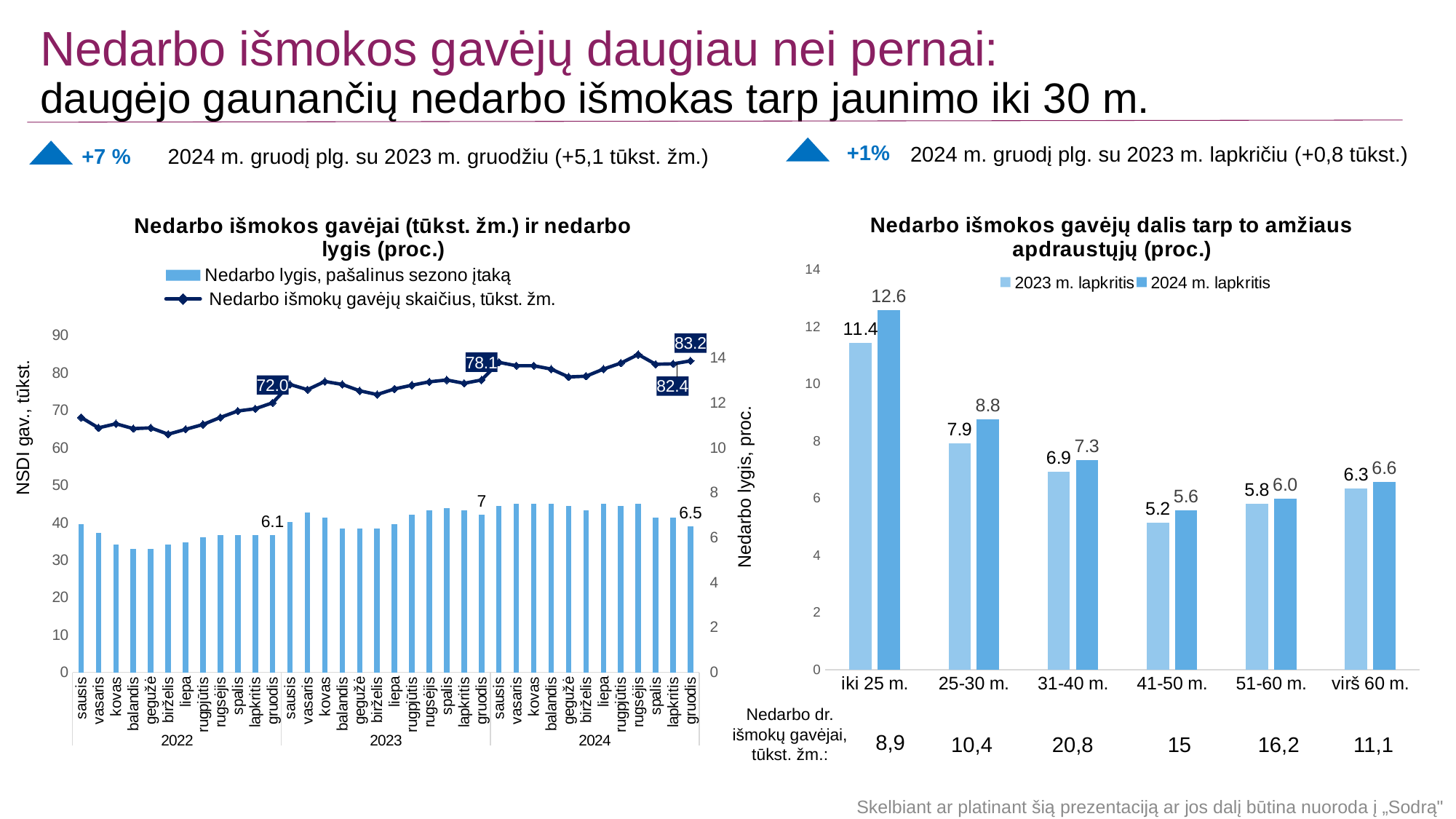
In the chart 'Nedarbo išmokos gavėjų dalis tarp to amžiaus apdraustųjų (proc.)', which age group has the lowest value in 2023 m. lapkritis? 41-50 m. In the chart 'Nedarbo išmokos gavėjų dalis tarp to amžiaus apdraustųjų (proc.)', which is larger for '51-60 m.': the 2023 m. lapkritis value or the 2024 m. lapkritis value? 2024 m. lapkritis In the chart 'Nedarbo išmokos gavėjų dalis tarp to amžiaus apdraustųjų (proc.)', what is the difference between the 2024 m. lapkritis and 2023 m. lapkritis values for '25-30 m.'? 0.9 How many series does the legend list in the chart 'Nedarbo išmokos gavėjų dalis tarp to amžiaus apdraustųjų (proc.)'? 2 How many age groups are shown in the chart 'Nedarbo išmokos gavėjų dalis tarp to amžiaus apdraustųjų (proc.)'? 6 In the chart 'Nedarbo išmokos gavėjai (tūkst. žm.) ir nedarbo lygis (proc.)', what is the labelled value of 'Nedarbo lygis, pašalinus sezono įtaką' for gruodis 2023? 7 In the chart 'Nedarbo išmokos gavėjų dalis tarp to amžiaus apdraustųjų (proc.)', which age group has the highest value in 2024 m. lapkritis? iki 25 m. In the chart 'Nedarbo išmokos gavėjai (tūkst. žm.) ir nedarbo lygis (proc.)', what is the difference between the labelled 'Nedarbo išmokų gavėjų skaičius' values for gruodis 2024 and gruodis 2022? 11.2 In the chart 'Nedarbo išmokos gavėjų dalis tarp to amžiaus apdraustųjų (proc.)', what is the value for '41-50 m.' in 2023 m. lapkritis? 5.2 In the chart 'Nedarbo išmokos gavėjai (tūkst. žm.) ir nedarbo lygis (proc.)', what is the labelled value of 'Nedarbo išmokų gavėjų skaičius, tūkst. žm.' for gruodis 2024? 83.2 What kind of chart is 'Nedarbo išmokos gavėjų dalis tarp to amžiaus apdraustųjų (proc.)'? Bar chart In the chart 'Nedarbo išmokos gavėjų dalis tarp to amžiaus apdraustųjų (proc.)', what is the value for 'iki 25 m.' in 2024 m. lapkritis? 12.6